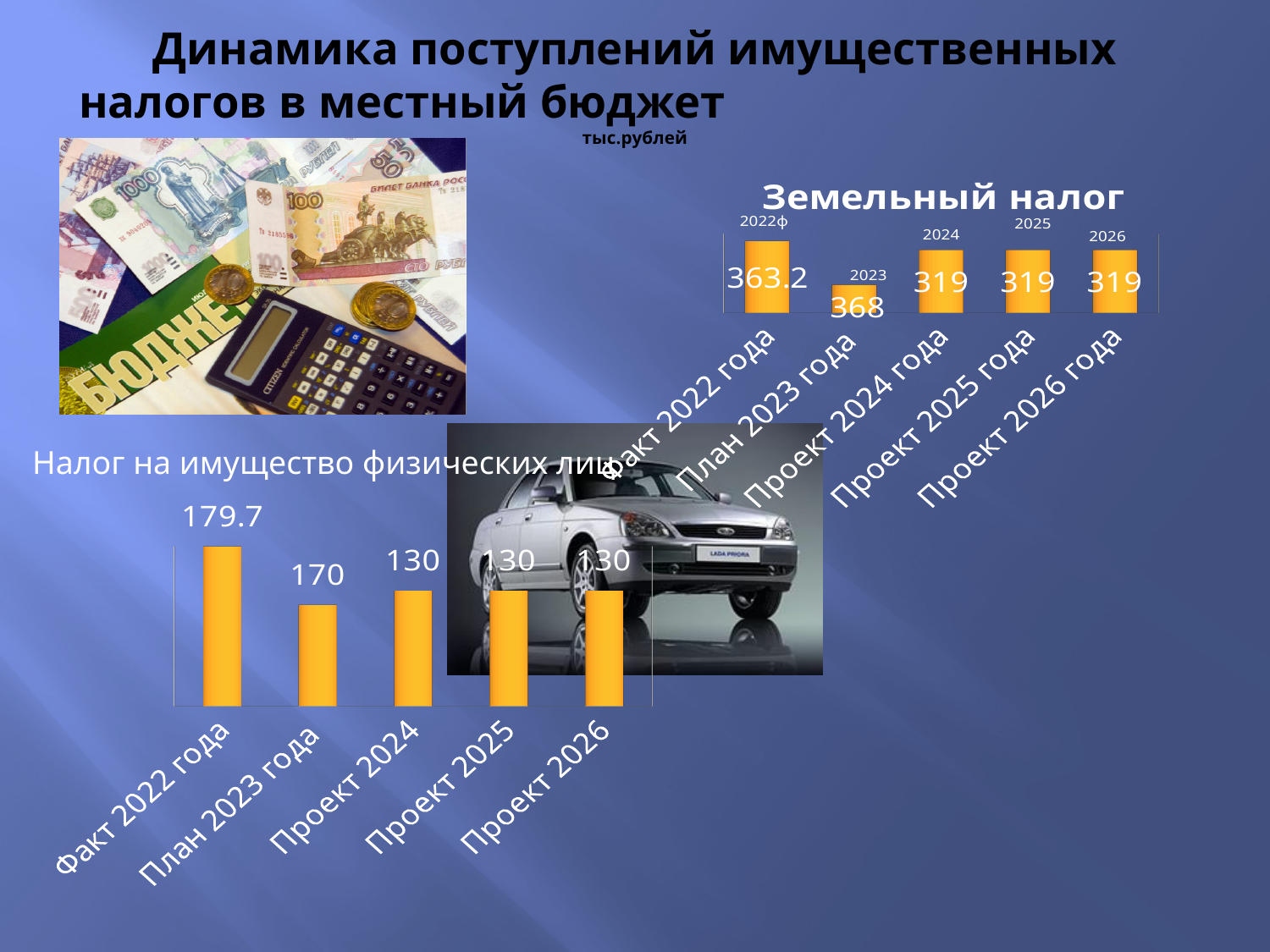
In the 'Налог на имущество физических лиц' chart, which category has the highest value? Факт 2022 года In the 'Налог на имущество физических лиц' chart, do the values rise or fall from Факт 2022 года to Проект 2024? fall In the 'Земельный налог' chart, what is the value for Проект 2025 года? 319 In the 'Налог на имущество физических лиц' chart, what is the difference between Факт 2022 года and Проект 2024? 49.7 In the 'Земельный налог' chart, what is the value for Факт 2022 года? 363.2 What type of chart is the 'Налог на имущество физических лиц' chart? bar chart In the 'Налог на имущество физических лиц' chart, what is the value for План 2023 года? 170 In the 'Земельный налог' chart, what is the value for План 2023 года? 368 In the 'Налог на имущество физических лиц' chart, which is larger: Факт 2022 года or План 2023 года? Факт 2022 года In the 'Земельный налог' chart, how many bars are plotted? 5 In the 'Налог на имущество физических лиц' chart, what is the value for Факт 2022 года? 179.7